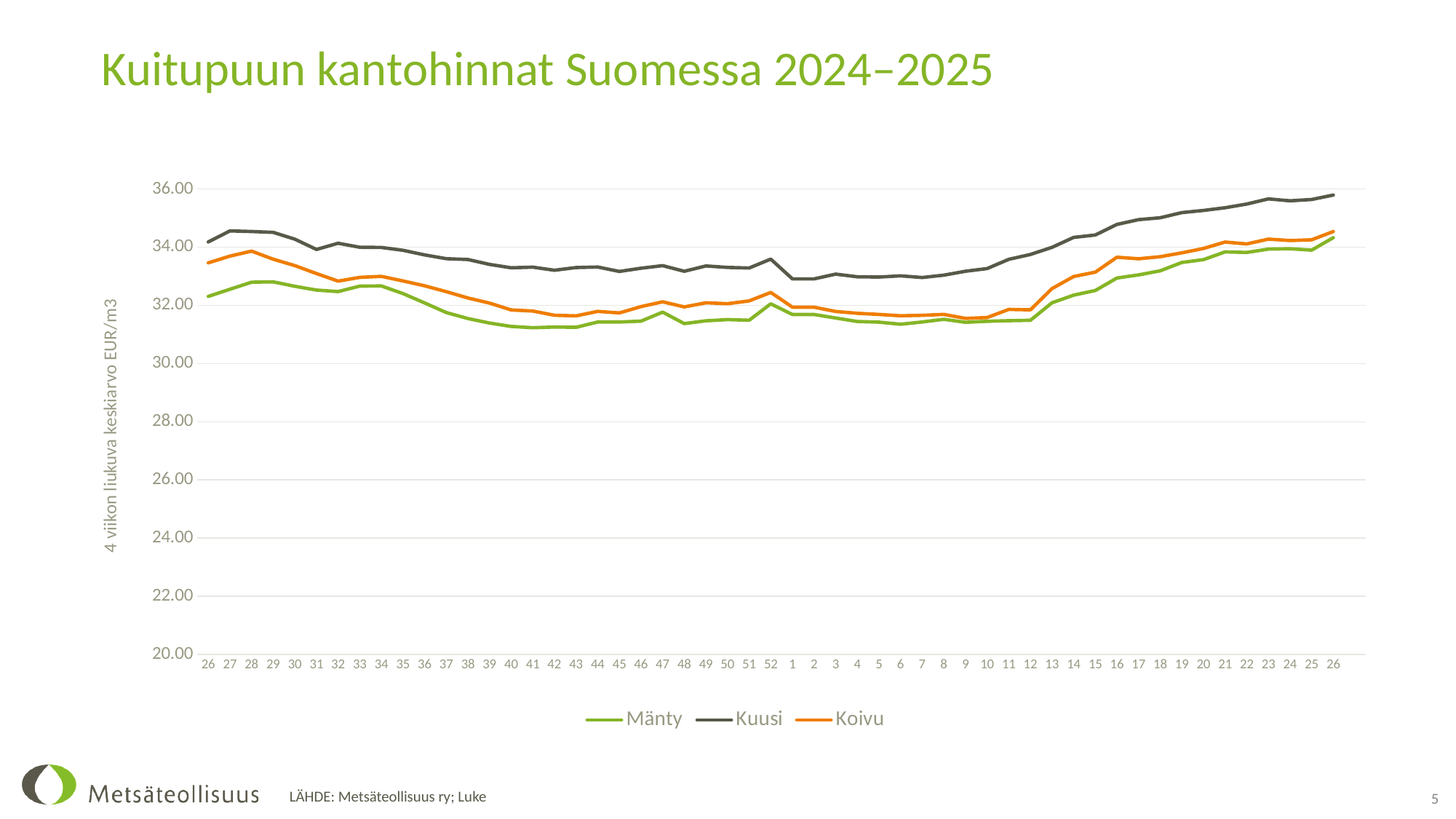
Which series has the highest values across the whole chart? Kuusi Is the value for Kuusi at the last week 26 greater or less than 35.00? greater How many series does the legend list? 3 At the first week 26, which is larger, Kuusi or Mänty? Kuusi Do the Mänty values rise or fall from week 12 to week 26 at the right end of the chart? rise Is the value for Koivu at week 16 greater or less than 33.00? greater Which series has the lowest values across the whole chart? Mänty Is the value for Mänty at week 40 greater or less than 32.00? less What is the title of the chart? Kuitupuun kantohinnat Suomessa 2024–2025 Which series are listed in the legend? Mänty, Kuusi, Koivu How many weekly points are plotted along the x axis? 53 What kind of chart is shown on the slide? line chart